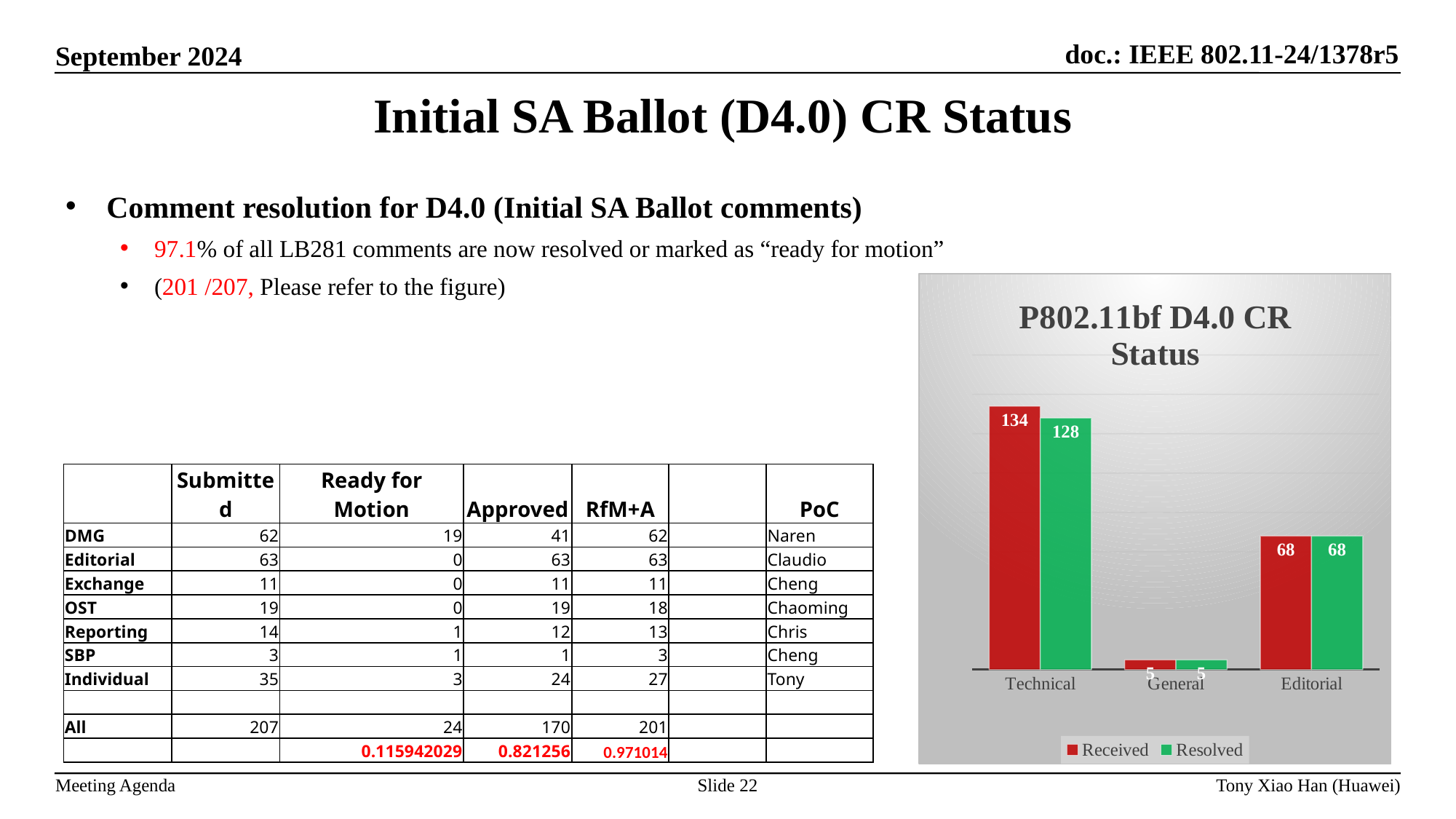
What is the Resolved value for General in the P802.11bf D4.0 CR Status chart? 5 What is the Received value for Technical in the P802.11bf D4.0 CR Status chart? 134 Which category has the lowest Resolved value in the P802.11bf D4.0 CR Status chart? General In the P802.11bf D4.0 CR Status chart, is the Received value for Technical or for Editorial larger? Technical What kind of chart is the P802.11bf D4.0 CR Status chart? Bar chart What is the Received value for Editorial in the P802.11bf D4.0 CR Status chart? 68 How many categories are shown on the x axis of the P802.11bf D4.0 CR Status chart? 3 What are the two series named in the legend of the P802.11bf D4.0 CR Status chart? Received and Resolved What is the difference between the Received and Resolved values for Technical in the P802.11bf D4.0 CR Status chart? 6 How many series does the legend of the P802.11bf D4.0 CR Status chart list? 2 Which category has the highest Received value in the P802.11bf D4.0 CR Status chart? Technical What is the Resolved value for Technical in the P802.11bf D4.0 CR Status chart? 128